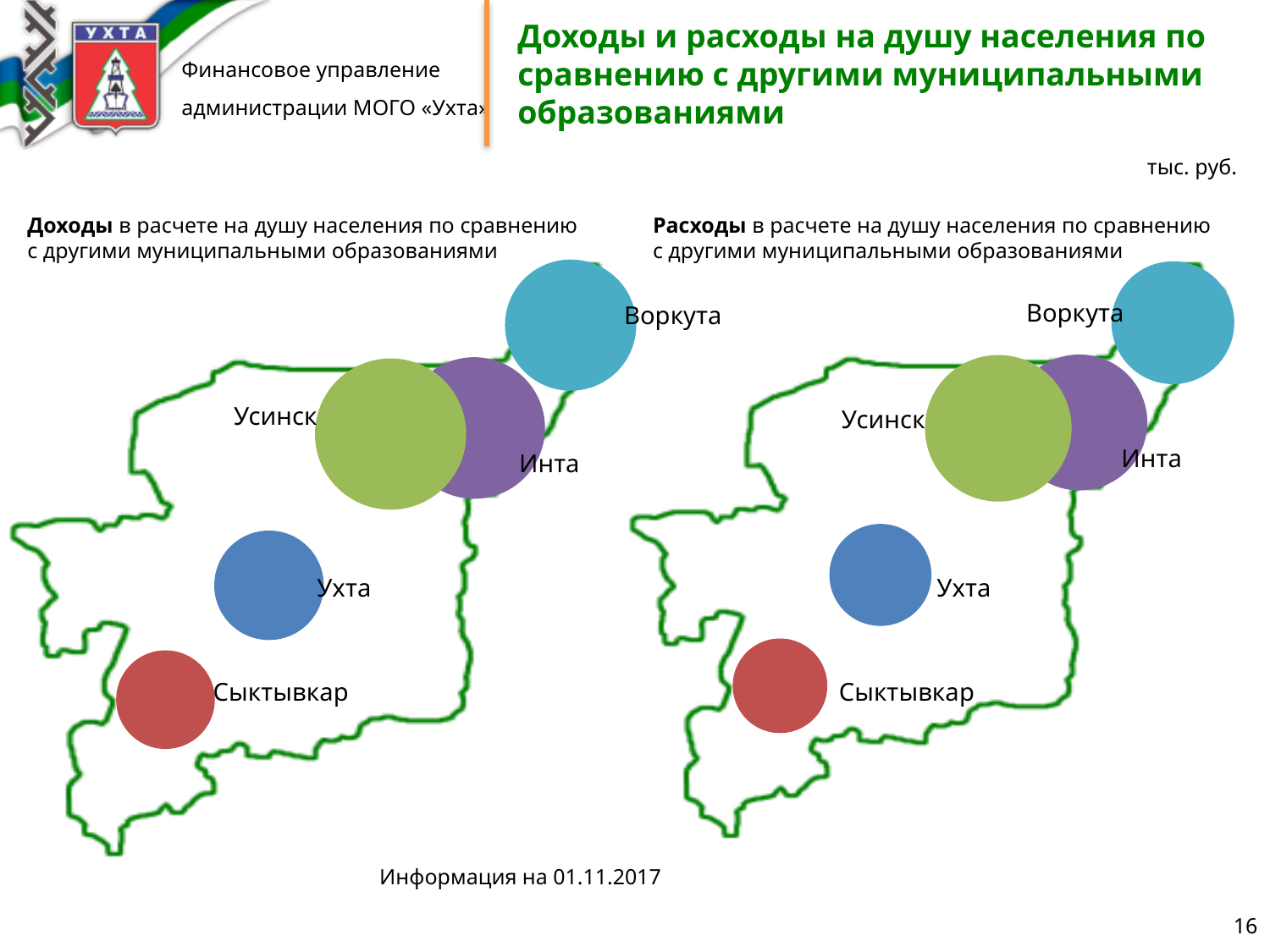
How many municipalities are shown as bubbles on the left chart (Доходы в расчете на душу населения)? 5 On the right chart (Расходы в расчете на душу населения), which municipality has the largest bubble? Усинск How many municipalities are shown as bubbles on the right chart (Расходы в расчете на душу населения)? 5 On the right chart (Расходы в расчете на душу населения), which bubble is larger: Инта or Ухта? Инта On the left chart (Доходы в расчете на душу населения), which municipality has the largest bubble? Усинск On the left chart (Доходы в расчете на душу населения), which bubble is larger: Воркута or Сыктывкар? Воркута What kind of chart is used on the left chart (Доходы в расчете на душу населения)? bubble chart What colour is the bubble for Ухта on the left chart (Доходы в расчете на душу населения)? blue On the right chart (Расходы в расчете на душу населения), which bubble is larger: Усинск or Сыктывкар? Усинск What unit is stated for the values on the slide? тыс. руб.